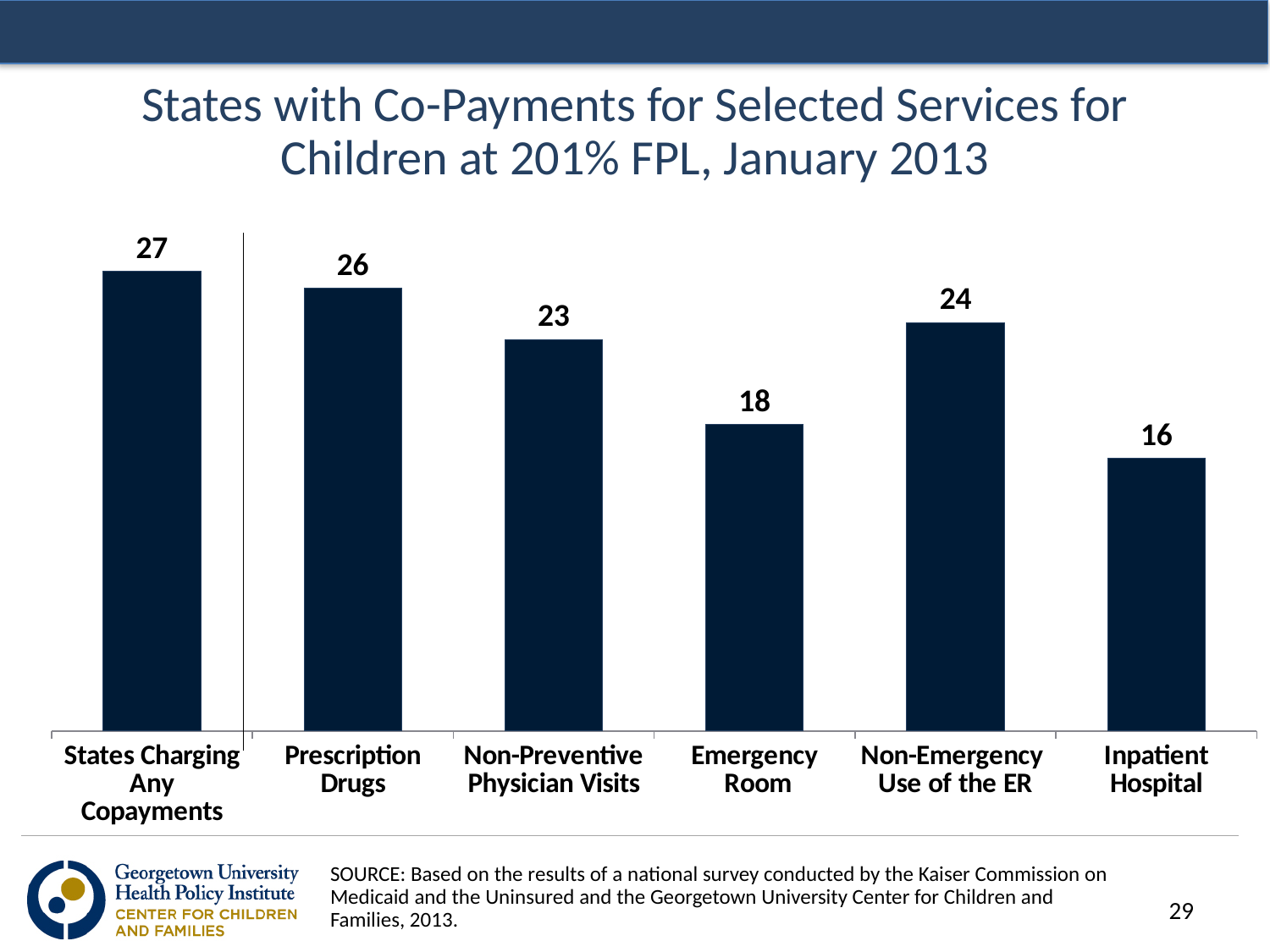
What kind of chart is shown on the slide? bar chart How many categories are shown in the chart? 6 What is the value for Prescription Drugs? 26 What is the value for Inpatient Hospital? 16 Which category has the lowest value? Inpatient Hospital What is the value for Emergency Room? 18 Which is larger, the value for Non-Preventive Physician Visits or the value for Non-Emergency Use of the ER? Non-Emergency Use of the ER What is the title of the chart? States with Co-Payments for Selected Services for Children at 201% FPL, January 2013 What is the value for Non-Emergency Use of the ER? 24 What is the difference between the values for Prescription Drugs and Inpatient Hospital? 10 What is the difference between the values for Non-Emergency Use of the ER and Emergency Room? 6 Which category has the highest value? States Charging Any Copayments